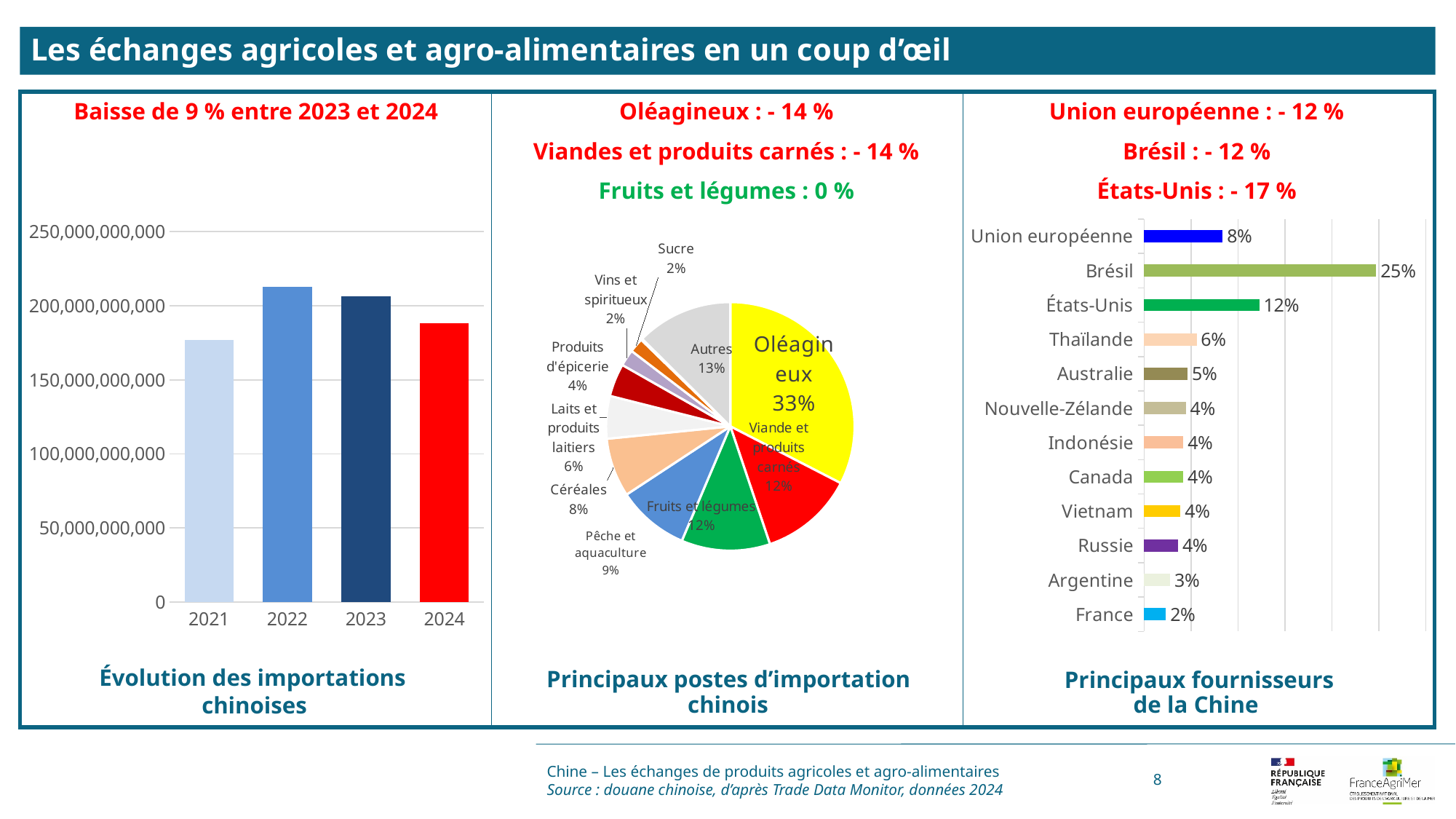
What kind of chart is 'Évolution des importations chinoises'? bar chart In the pie chart 'Principaux postes d'importation chinois', what share does Oléagineux have? 33% In the chart 'Principaux fournisseurs de la Chine', what is the difference in percentage points between Brésil and États-Unis? 13 In the pie chart 'Principaux postes d'importation chinois', how many slices are there? 10 In the chart 'Évolution des importations chinoises', is the value for 2024 greater or less than 200,000,000,000? less In the chart 'Évolution des importations chinoises', which year has the lowest value? 2021 In the pie chart 'Principaux postes d'importation chinois', what is the difference in percentage points between Oléagineux and Céréales? 25 In the chart 'Évolution des importations chinoises', how many years are shown on the x axis? 4 In the chart 'Principaux fournisseurs de la Chine', which supplier has the highest value? Brésil In the pie chart 'Principaux postes d'importation chinois', what is the share for Pêche et aquaculture? 9% In the chart 'Évolution des importations chinoises', is the value for 2022 greater or less than 200,000,000,000? greater In the chart 'Principaux fournisseurs de la Chine', what is the value for Thaïlande? 6%